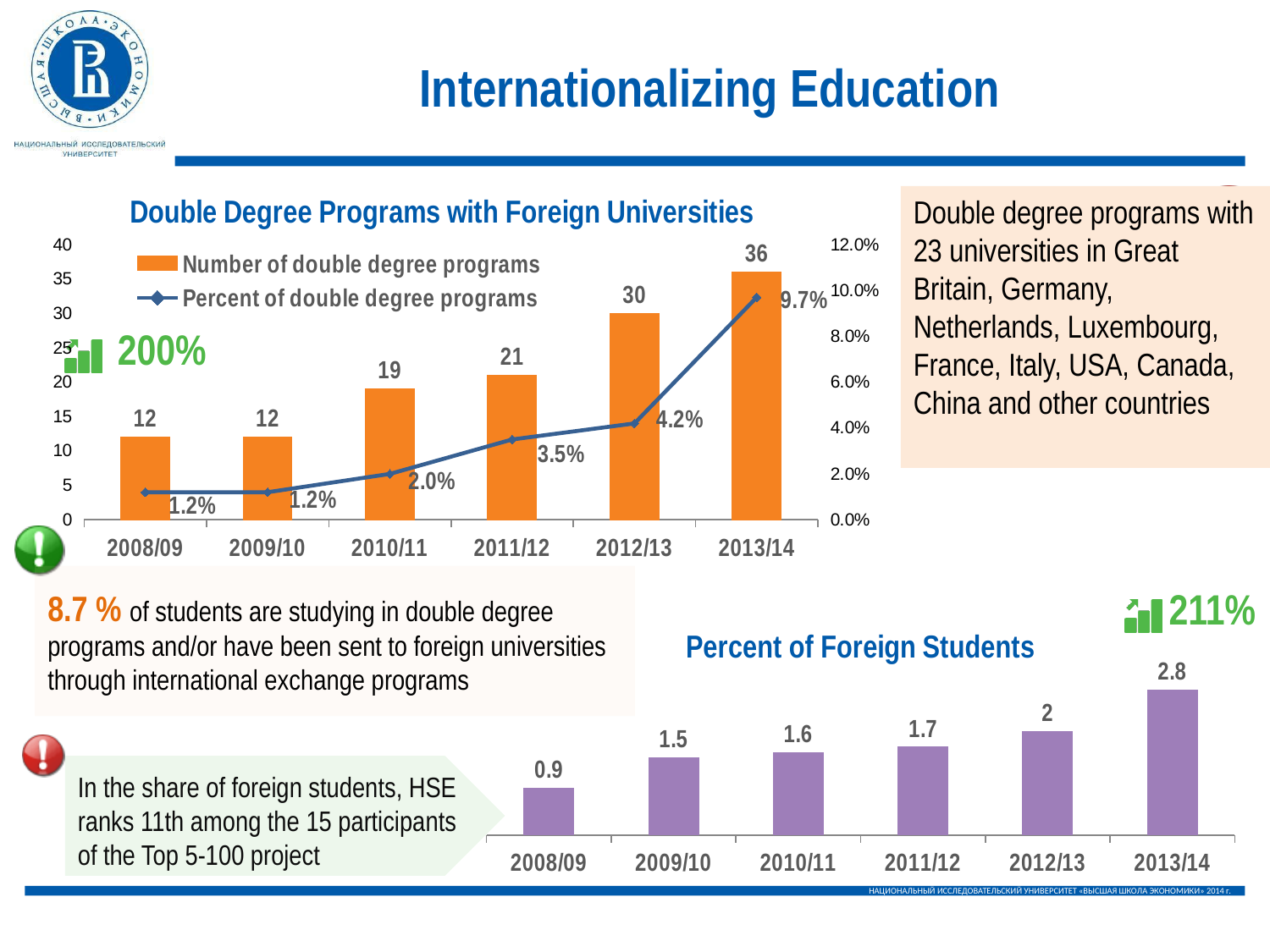
In the 'Double Degree Programs with Foreign Universities' chart, what is the percent of double degree programs in 2011/12? 3.5% In the 'Double Degree Programs with Foreign Universities' chart, what colour are the bars for the number of double degree programs? orange In the 'Double Degree Programs with Foreign Universities' chart, which year has the highest number of double degree programs? 2013/14 In the 'Double Degree Programs with Foreign Universities' chart, how many academic years are shown on the x axis? 6 In the 'Double Degree Programs with Foreign Universities' chart, does the percent of double degree programs rise or fall from 2008/09 to 2013/14? rise In the 'Percent of Foreign Students' chart, what is the value for 2010/11? 1.6 In the 'Percent of Foreign Students' chart, which year has the lowest value? 2008/09 In the 'Double Degree Programs with Foreign Universities' chart, what is the number of double degree programs in 2013/14? 36 What kind of chart is the 'Percent of Foreign Students' chart? bar chart In the 'Double Degree Programs with Foreign Universities' chart, what is the difference in the number of double degree programs between 2013/14 and 2012/13? 6 In the 'Percent of Foreign Students' chart, what is the difference between the values for 2013/14 and 2008/09? 1.9 In the 'Double Degree Programs with Foreign Universities' chart, how many series does the legend list? 2